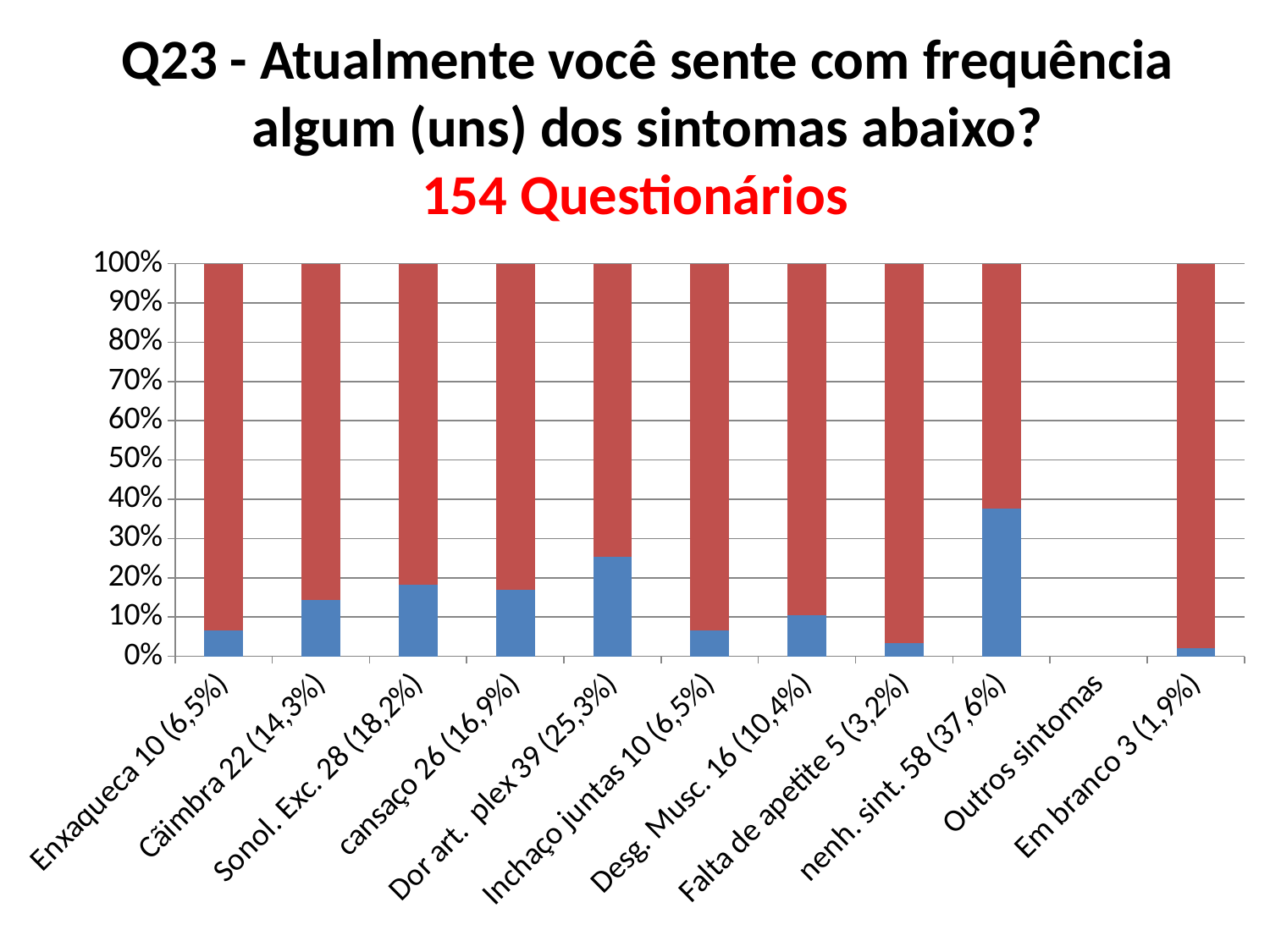
How many categories are shown along the x axis of the chart? 11 Which has a higher percentage in its label: 'Sonol. Exc.' or 'cansaço'? Sonol. Exc. How many questionnaires does the slide subtitle say were collected? 154 What kind of chart is shown on the slide? Stacked bar chart Which category has the largest blue portion of its bar? nenh. sint. 58 (37,6%) How many respondents are listed for 'Cãimbra' in its category label? 22 What is the difference between the percentages given for 'nenh. sint.' (37,6%) and 'Dor art. plex' (25,3%)? 12,3% Is the blue portion of the bar for 'Dor art. plex' greater or less than 20%? greater According to the category label, what percentage is given for 'Dor art. plex'? 25,3% Is the blue portion of the bar for 'Falta de apetite' greater or less than 10%? less What is the total height of each stacked bar, as shown on the y axis? 100% According to the category label, what percentage is given for 'nenh. sint.'? 37,6%